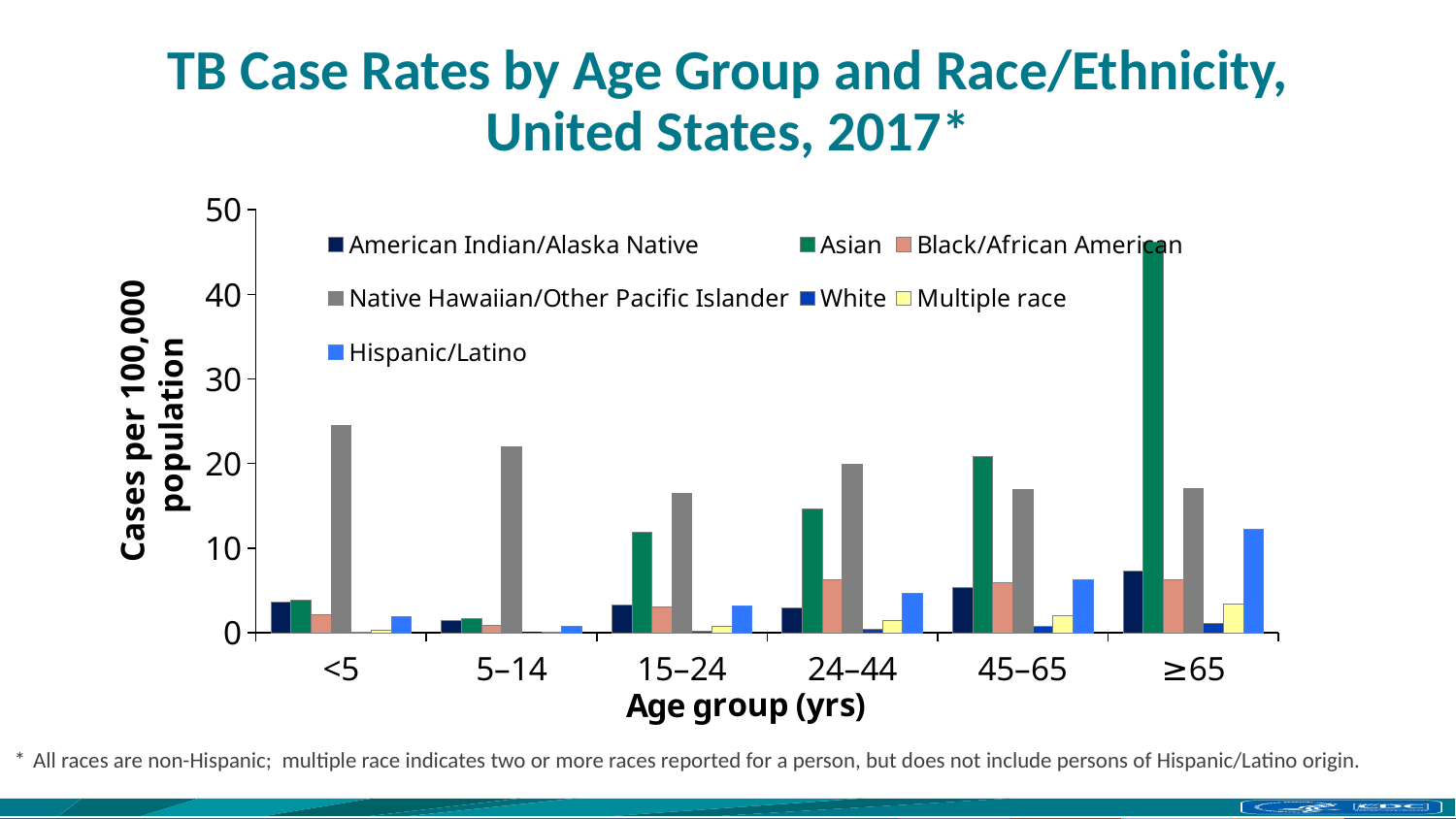
What kind of chart is shown on the slide? Bar chart In the 45–65 age group, which is larger: the Asian rate or the Native Hawaiian/Other Pacific Islander rate? Asian In the 15–24 age group, which is larger: the Asian rate or the Native Hawaiian/Other Pacific Islander rate? Native Hawaiian/Other Pacific Islander Is the Asian case rate for the ≥65 age group greater or less than 40? greater Is the Hispanic/Latino case rate for the ≥65 age group greater or less than 10? greater Which race/ethnicity has the highest case rate in the <5 age group? Native Hawaiian/Other Pacific Islander How many race/ethnicity series does the legend list? 7 How many age groups are shown on the x axis? 6 In which age group is the Hispanic/Latino case rate lowest? 5–14 From the 5–14 age group to the ≥65 age group, does the Asian case rate rise or fall? rise Is the Native Hawaiian/Other Pacific Islander case rate for the <5 age group greater or less than 20? greater In which age group is the Asian case rate highest? ≥65